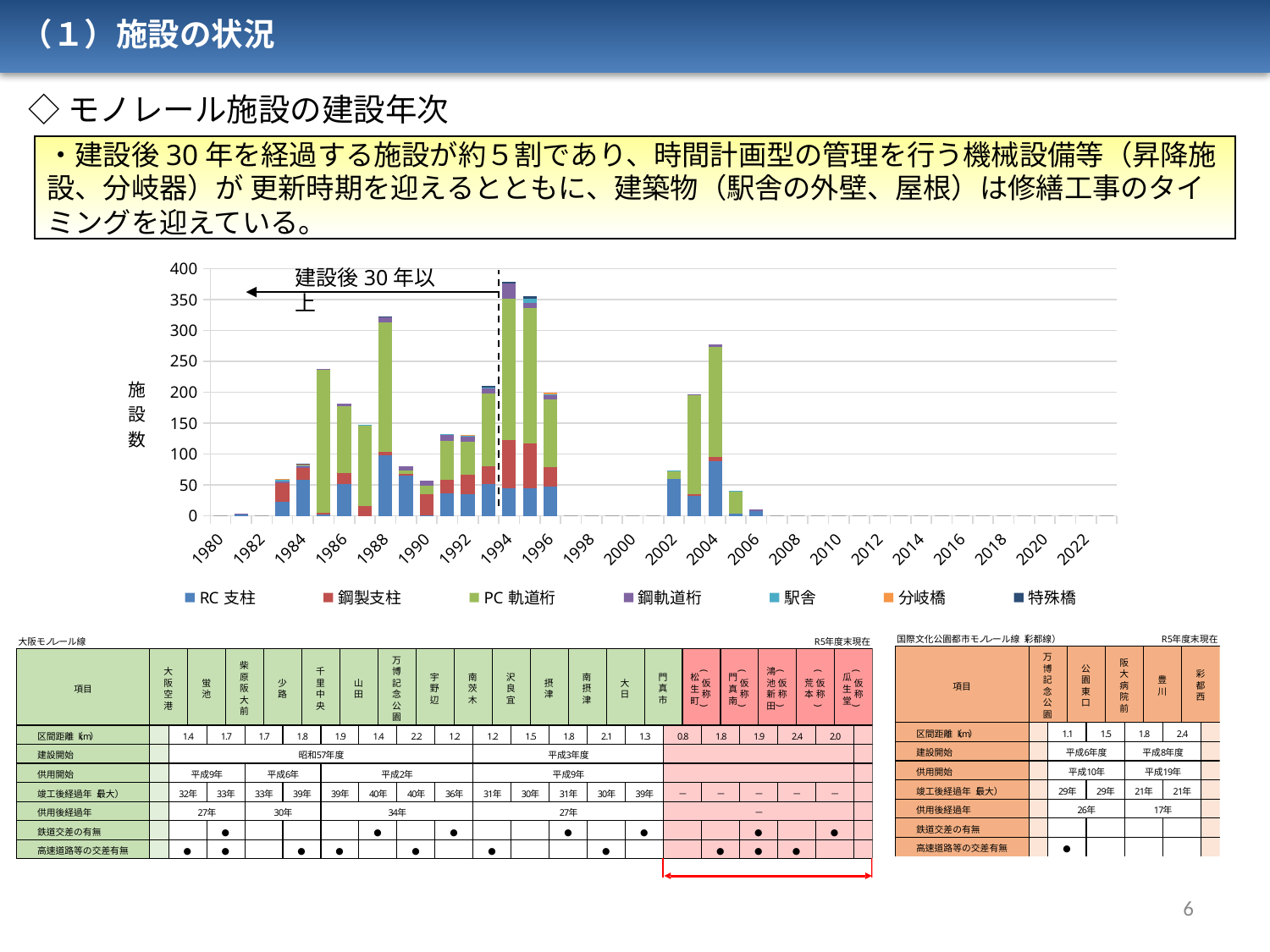
Is the total value of the bar for 1988 greater or less than 300? greater What is the first entry in the chart legend? RC 支柱 How many series does the chart legend list? 7 Is the total value of the bar for 2005 greater or less than 50? less Which bar is taller, 2004 or 2003? 2004 Is the total value of the bar for 1985 greater or less than 250? less Which year has the tallest stacked bar in the chart? 1994 What kind of chart is shown on the slide? bar chart What is the label on the vertical axis of the chart? 施設数 Which bar is taller, 1988 or 1985? 1988